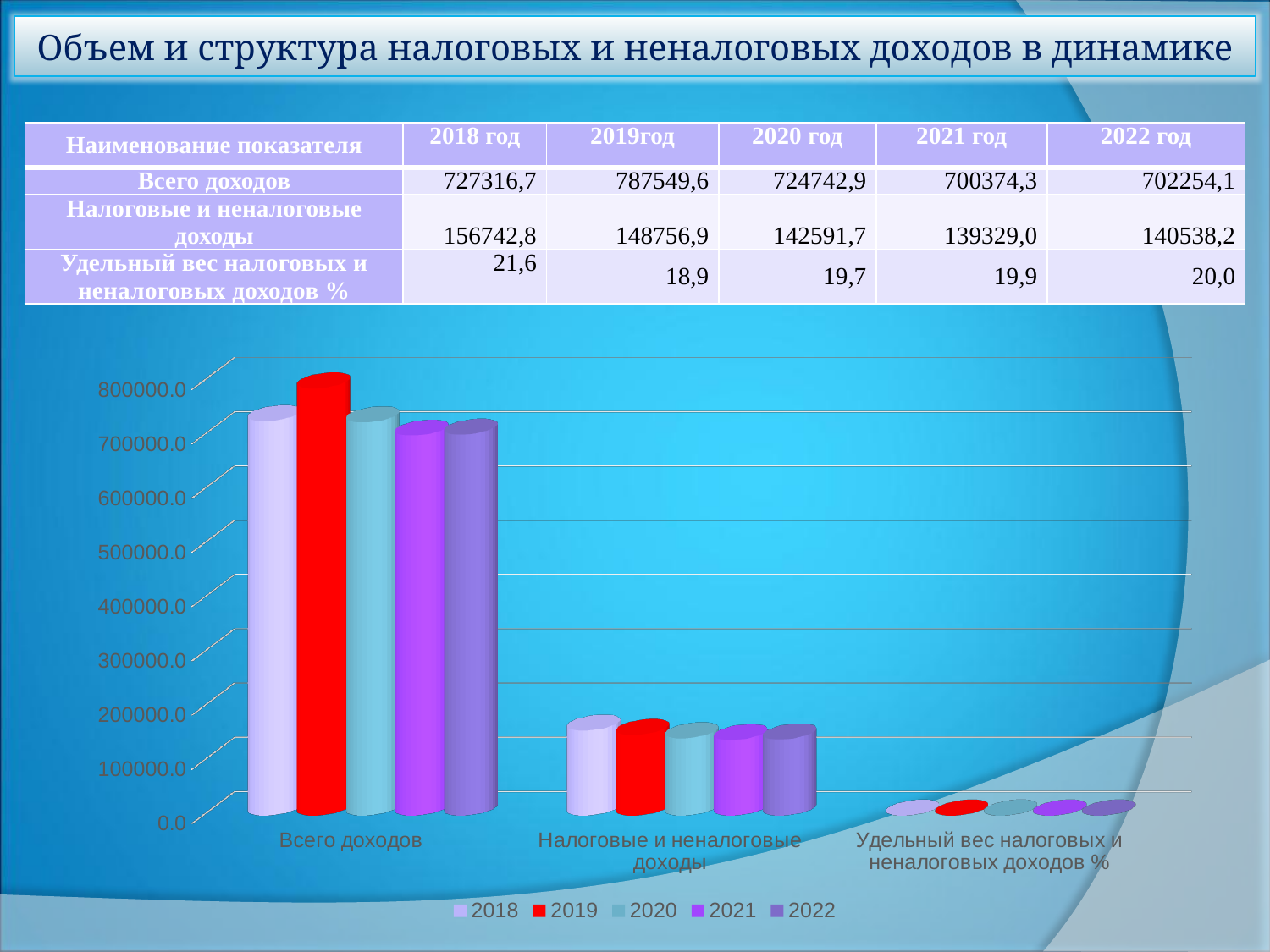
Which year has the highest bar in the 'Налоговые и неналоговые доходы' category? 2018 What is the value of 'Всего доходов' for 2019 according to the table on the slide? 787549,6 How many series does the chart legend list? 5 What colour represents the 2019 series in the chart legend? red Which is larger for 'Всего доходов': the 2018 bar or the 2019 bar? 2019 Is the 2018 bar for 'Налоговые и неналоговые доходы' greater or less than 200000.0? less Which year has the highest bar in the 'Всего доходов' category? 2019 Do the bars for 'Налоговые и неналоговые доходы' rise or fall from 2018 to 2021? fall What is the value of 'Налоговые и неналоговые доходы' for 2022 according to the table on the slide? 140538,2 Is the 2019 bar for 'Всего доходов' greater or less than 700000.0? greater How many categories are shown along the x axis of the chart? 3 What kind of chart is shown on the slide? bar chart